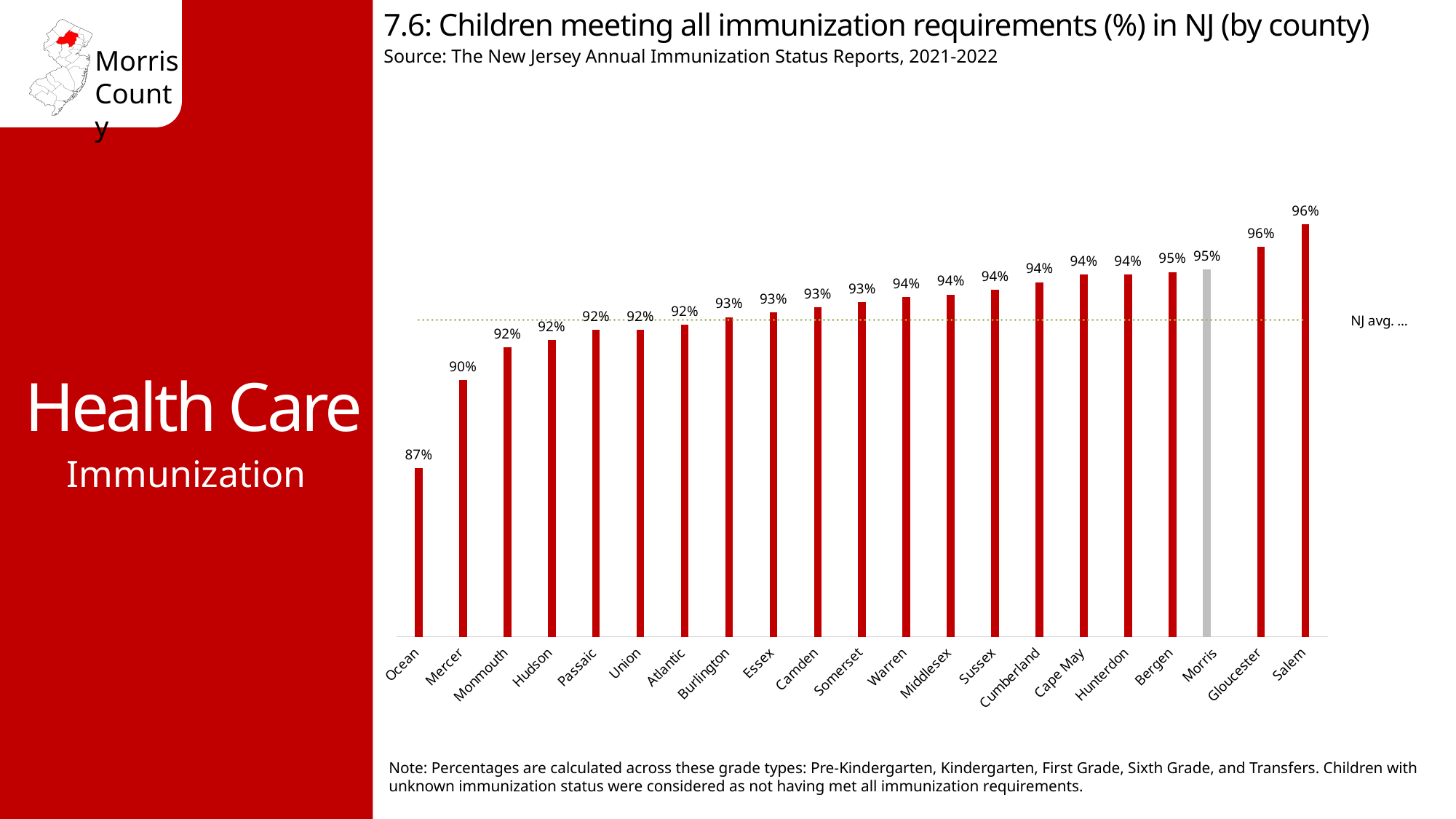
How many counties are shown on the chart? 21 What is the difference in percentage points between Salem and Ocean? 9 percentage points What is the value shown for Morris County? 95% What kind of chart is shown on the slide? Bar chart Which county's bar is coloured grey instead of red? Morris Do the values rise or fall moving from left to right along the x axis? Rise Which county has the lowest percentage of children meeting all immunization requirements? Ocean Which has a higher value, Bergen or Monmouth? Bergen What percentage of children in Ocean County meet all immunization requirements? 87% What is the value shown for Hunterdon County? 94% What is the value shown for Mercer County? 90% What is the difference in percentage points between Mercer and Ocean? 3 percentage points